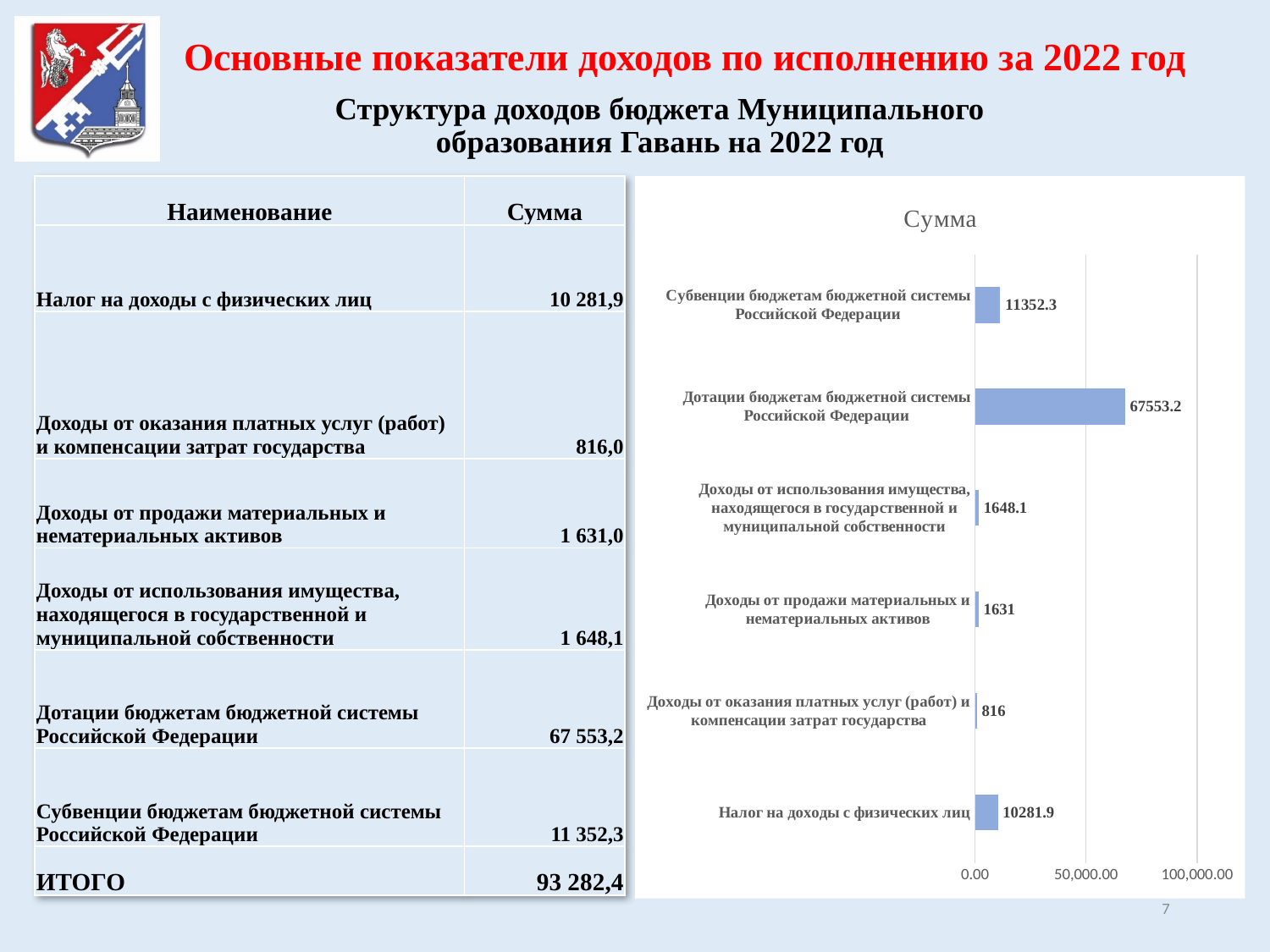
What type of chart is shown on the slide? bar chart What is the title of the chart? Сумма Which category has the lowest value in the chart? Доходы от оказания платных услуг (работ) и компенсации затрат государства What is the difference between the values for Субвенции бюджетам бюджетной системы Российской Федерации and Налог на доходы с физических лиц? 1070.4 What is the value for Субвенции бюджетам бюджетной системы Российской Федерации in the chart? 11352.3 What is the value for Дотации бюджетам бюджетной системы Российской Федерации in the chart? 67553.2 Is the value for Дотации бюджетам бюджетной системы Российской Федерации greater or less than 50,000.00? greater Which is larger: the value for Доходы от использования имущества, находящегося в государственной и муниципальной собственности or the value for Доходы от продажи материальных и нематериальных активов? Доходы от использования имущества, находящегося в государственной и муниципальной собственности Which category has the highest value in the chart? Дотации бюджетам бюджетной системы Российской Федерации What is the value for Доходы от оказания платных услуг (работ) и компенсации затрат государства in the chart? 816 What is the value for Налог на доходы с физических лиц in the chart? 10281.9 How many categories are plotted in the chart? 6